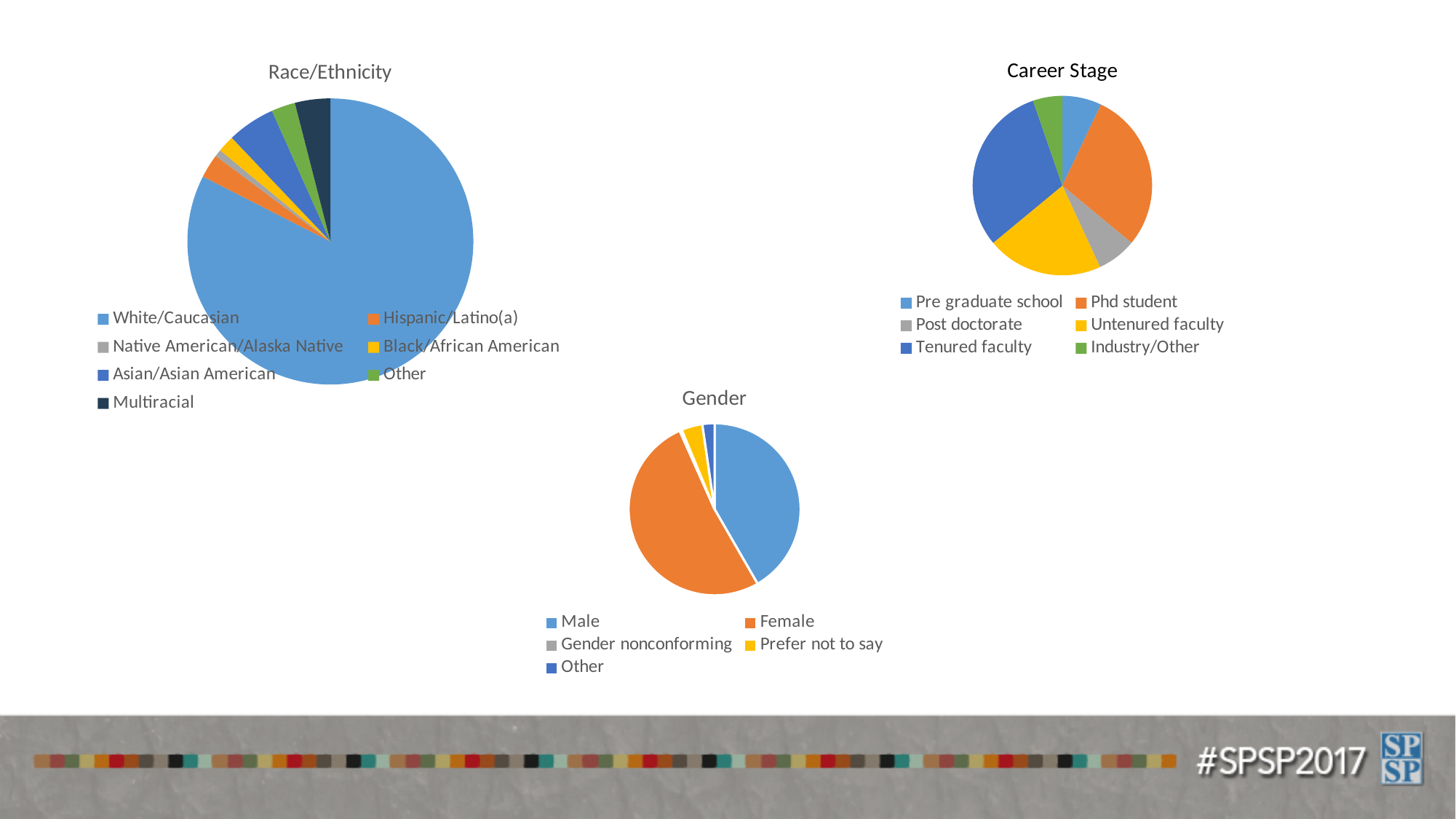
What is the title of the chart in the top right of the slide? Career Stage In the Race/Ethnicity chart, which category has the largest slice? White/Caucasian How many categories does the legend of the Career Stage chart list? 6 In the Career Stage chart, which slice is larger: Untenured faculty or Post doctorate? Untenured faculty In the Race/Ethnicity chart, which slice is larger: Asian/Asian American or Hispanic/Latino(a)? Asian/Asian American How many categories does the legend of the Race/Ethnicity chart list? 7 In the Career Stage chart, which slice is larger: Phd student or Pre graduate school? Phd student In the Race/Ethnicity chart, which category has the smallest slice? Native American/Alaska Native What kind of chart is the Race/Ethnicity chart? Pie chart In the Gender chart, which category has the largest slice? Female How many categories does the legend of the Gender chart list? 5